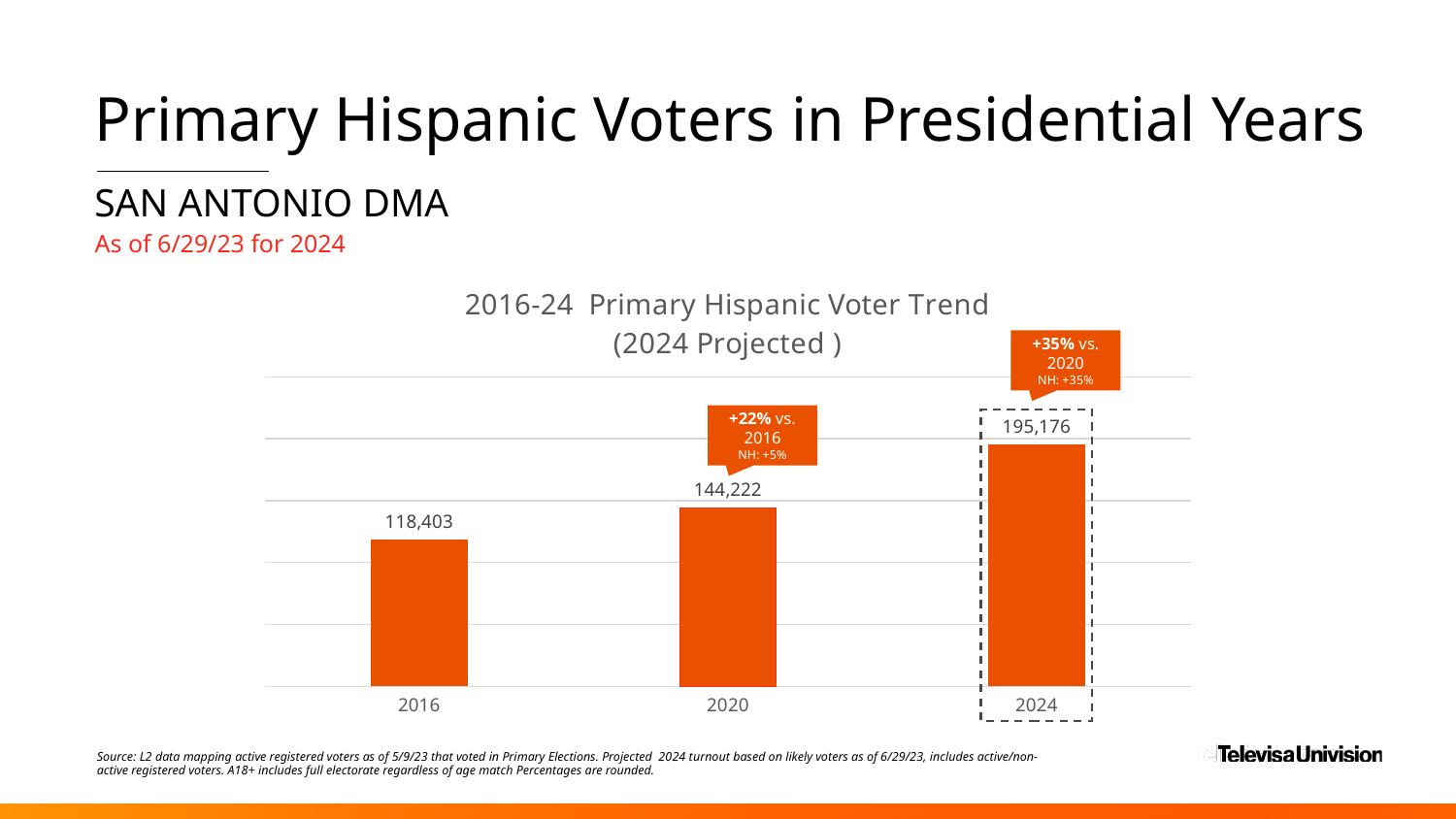
What is the difference between the 2024 and 2020 values? 50,954 What is the projected value for 2024? 195,176 What percentage change vs. 2020 does the callout above the 2024 bar show? +35% What is the value for 2016? 118,403 Which year has the lowest value? 2016 Which is larger, the value for 2020 or the value for 2024? 2024 Which year has the highest value? 2024 What kind of chart is shown? Bar chart Do the values rise or fall from 2016 to 2024? Rise What is the difference between the 2020 and 2016 values? 25,819 What is the value for 2020? 144,222 How many years are shown on the chart? 3